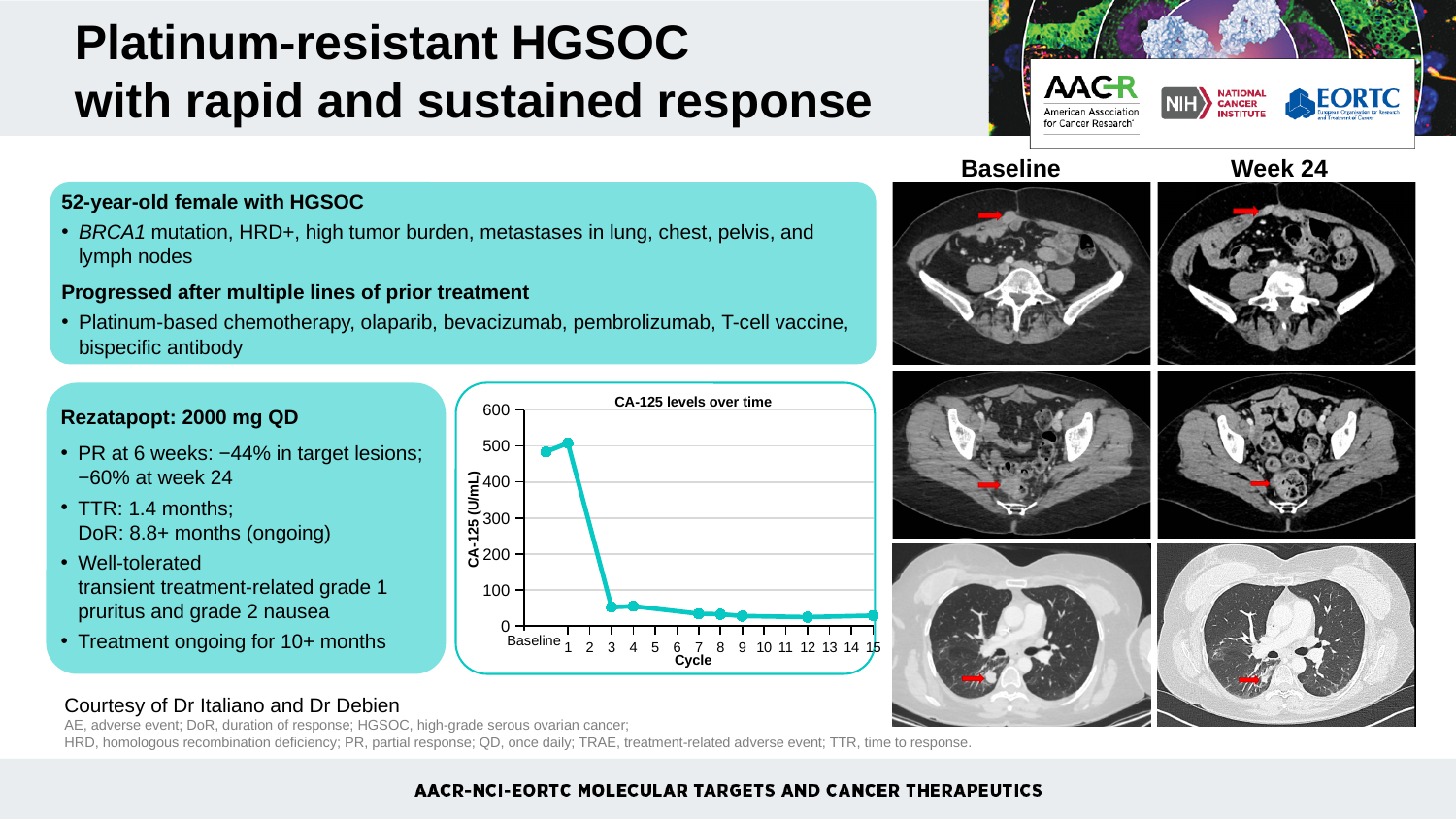
What is the highest value shown on the y axis of the CA-125 chart? 600 Do CA-125 levels rise or fall over the cycles shown on the chart? fall Is the CA-125 value at cycle 3 greater or less than 100? less What is the last cycle number labelled on the x axis of the CA-125 chart? 15 What is the title of the chart on the slide? CA-125 levels over time What kind of chart is the CA-125 levels over time chart? line chart Is the CA-125 value at cycle 15 greater or less than 100? less What is the label of the y axis on the CA-125 chart? CA-125 (U/mL) Is the CA-125 value at Baseline greater or less than 400? greater Which has the higher CA-125 value, Baseline or cycle 3? Baseline Which has the higher CA-125 value, cycle 3 or cycle 15? cycle 3